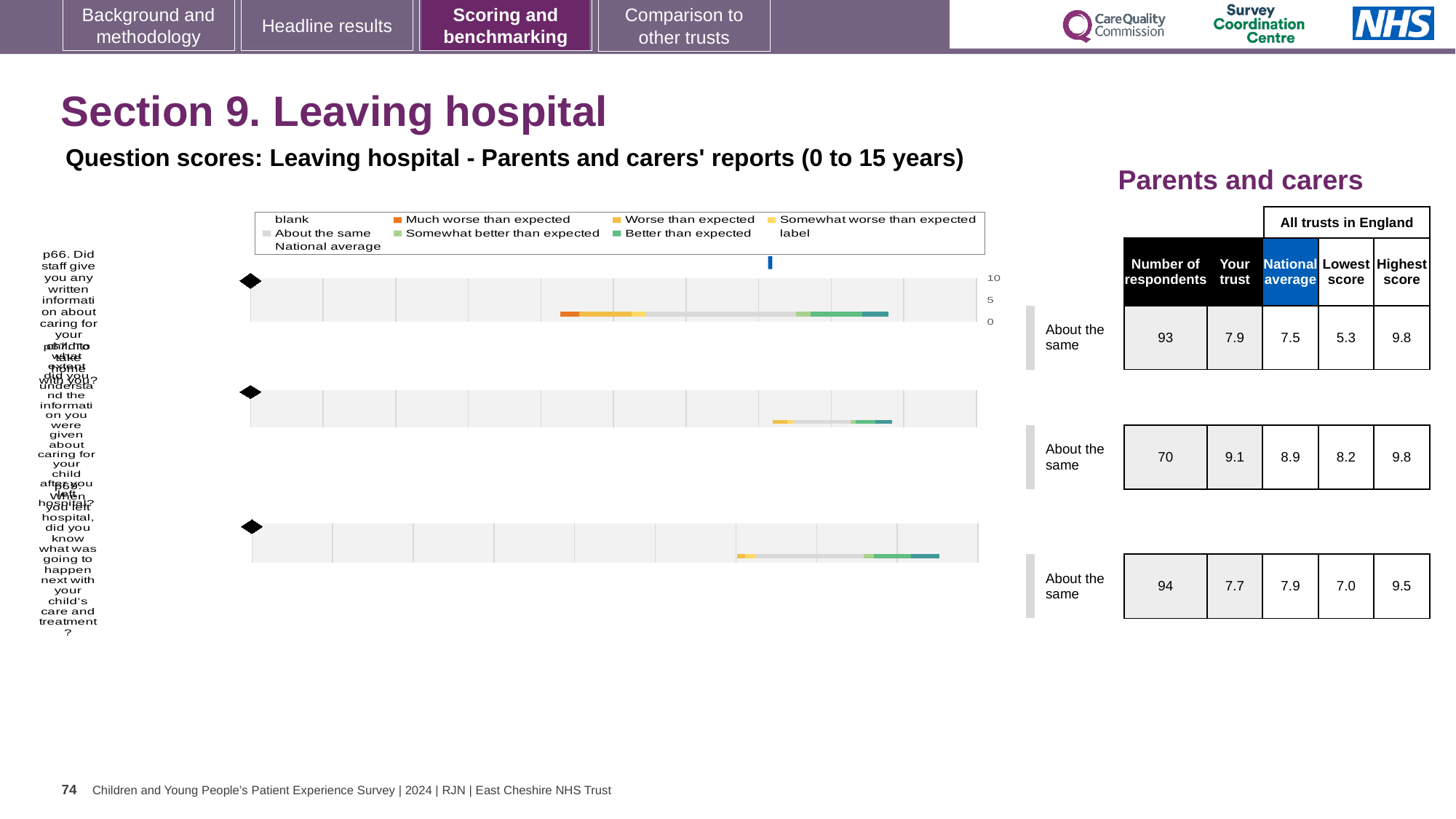
For the top chart, what is the difference between the highest score and the lowest score in the table? 4.5 Which chart row has the highest number of respondents in the table? the bottom row (94) How many question bars (charts) are shown on the slide? 3 In the table beside the middle chart, what is the national average score? 8.9 What colour does the legend use for 'Much worse than expected'? orange In the table beside the top chart, what is the 'Your trust' score? 7.9 For the middle chart, which is larger: the 'Your trust' score or the national average? Your trust What benchmark category is shown next to each of the three charts? About the same What is the highest value shown on the chart axis? 10 What kind of chart is used on this slide to show the question scores? bar chart For the bottom chart, which is larger: the 'Your trust' score or the national average? National average